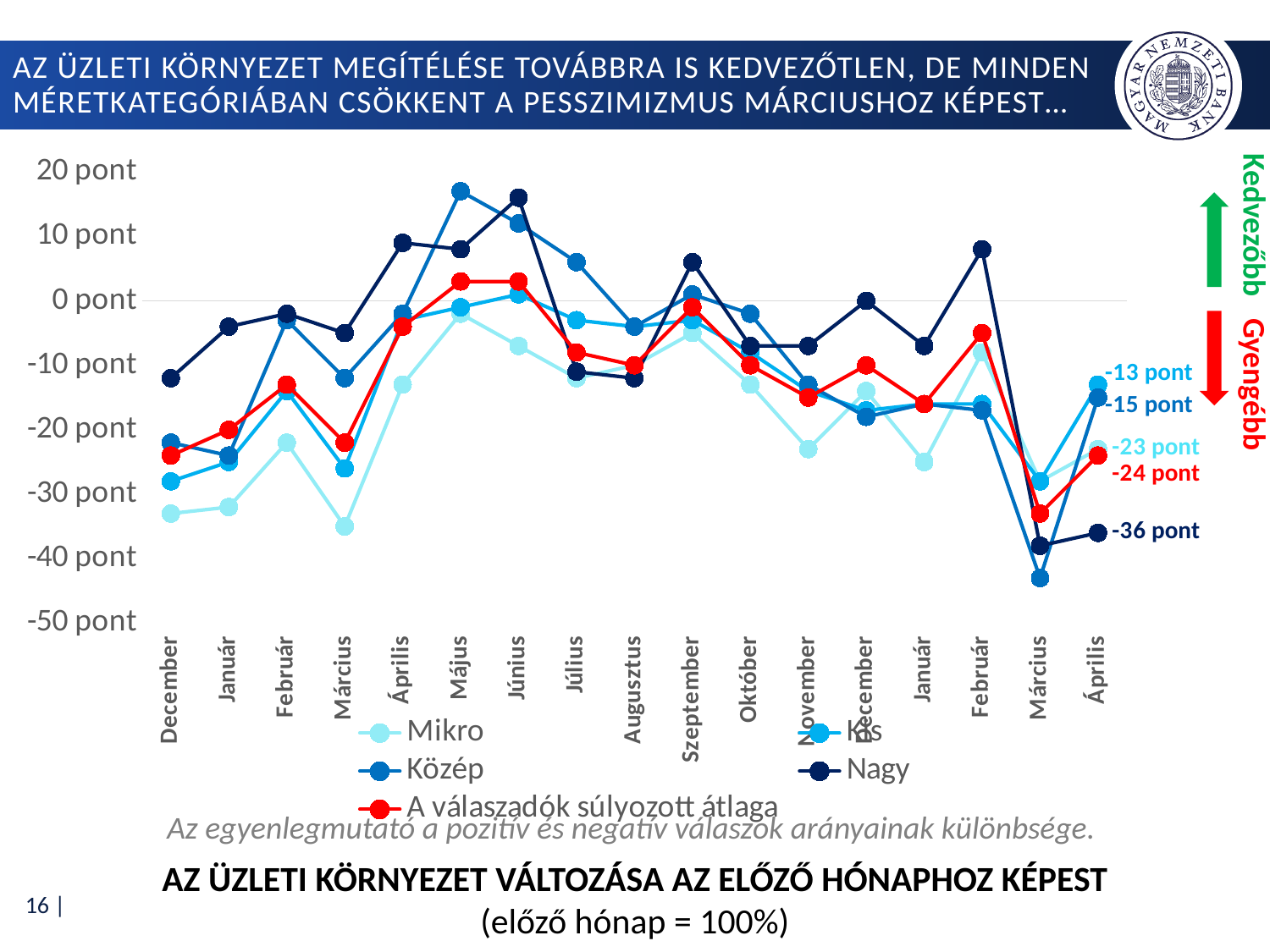
How many series does the legend list? 5 What kind of chart is shown on the slide? line chart What is the value for the Kis series at the final Április point? -13 pont Which legend entry is drawn in red? A válaszadók súlyozott átlaga What is the value for A válaszadók súlyozott átlaga at the final Április point? -24 pont What is the value for the Mikro series at the final Április point? -23 pont At the final Április point, which is higher: Közép or Mikro? Közép What is the difference between the Kis and Nagy values at the final Április point? 23 pont Which series has the lowest value at the final Április point? Nagy What is the value for the Nagy series at the final Április point? -36 pont Is the value for the Közép series in Május greater or less than 10 pont? greater How many months are shown along the x axis? 17